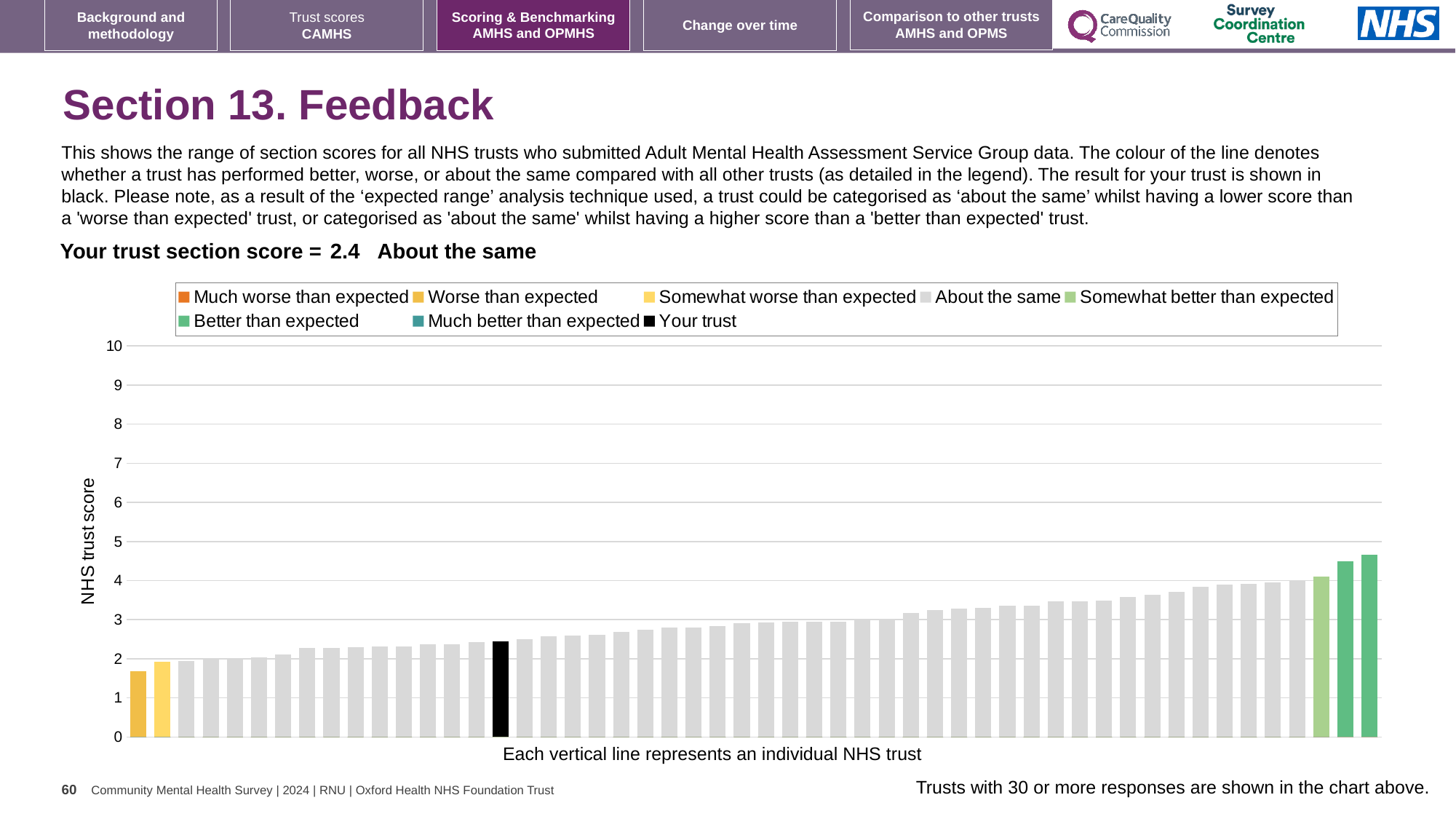
What is the label on the vertical axis of the chart? NHS trust score Is the value of the shortest bar in the chart greater or less than 2? less Which category is your trust placed in for this section? About the same How many bars are coloured yellow (worse than expected categories)? 2 Is the value for your trust (the black bar) greater or less than 3? less What kind of chart is shown on the slide? bar chart Do the bar values rise or fall moving from left to right along the x axis? rise Is the value of the tallest bar in the chart greater or less than 4? greater What colour is the bar representing your trust? black How many entries does the chart legend list? 8 How many bars are coloured green (better than expected categories)? 3 What is the section score for your trust shown on the slide? 2.4